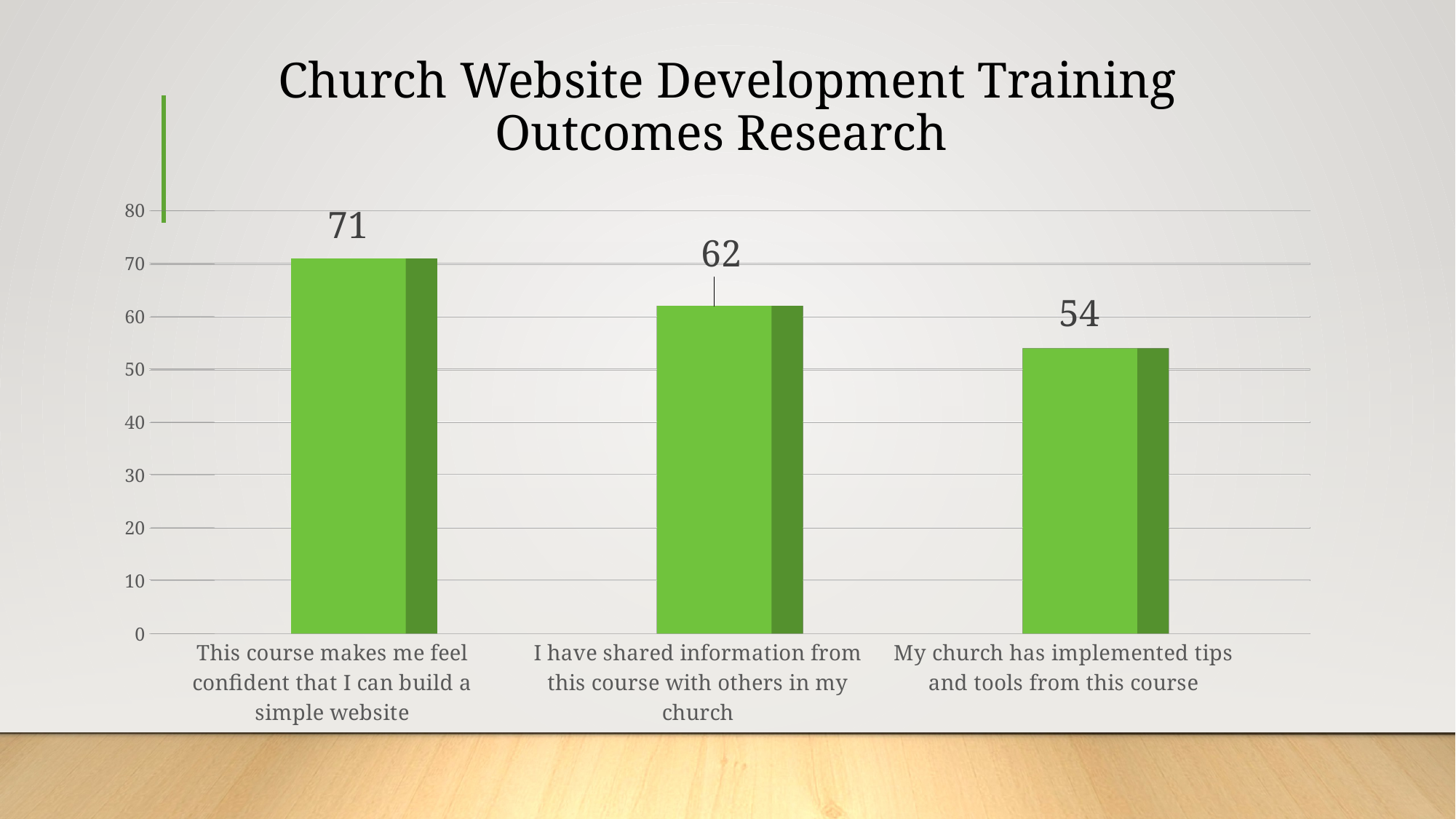
Which category has the lowest value? My church has implemented tips and tools from this course Is the value for "My church has implemented tips and tools from this course" greater or less than 60? less What is the difference between the values for "I have shared information from this course with others in my church" and "My church has implemented tips and tools from this course"? 8 How many categories are shown in the chart? 3 What is the difference between the values for "This course makes me feel confident that I can build a simple website" and "My church has implemented tips and tools from this course"? 17 Which is larger: the value for "I have shared information from this course with others in my church" or for "My church has implemented tips and tools from this course"? I have shared information from this course with others in my church What is the value for "I have shared information from this course with others in my church"? 62 What is the title of the chart? Church Website Development Training Outcomes Research What is the value for "My church has implemented tips and tools from this course"? 54 Which category has the highest value? This course makes me feel confident that I can build a simple website What kind of chart is shown on the slide? Bar chart What is the value for "This course makes me feel confident that I can build a simple website"? 71